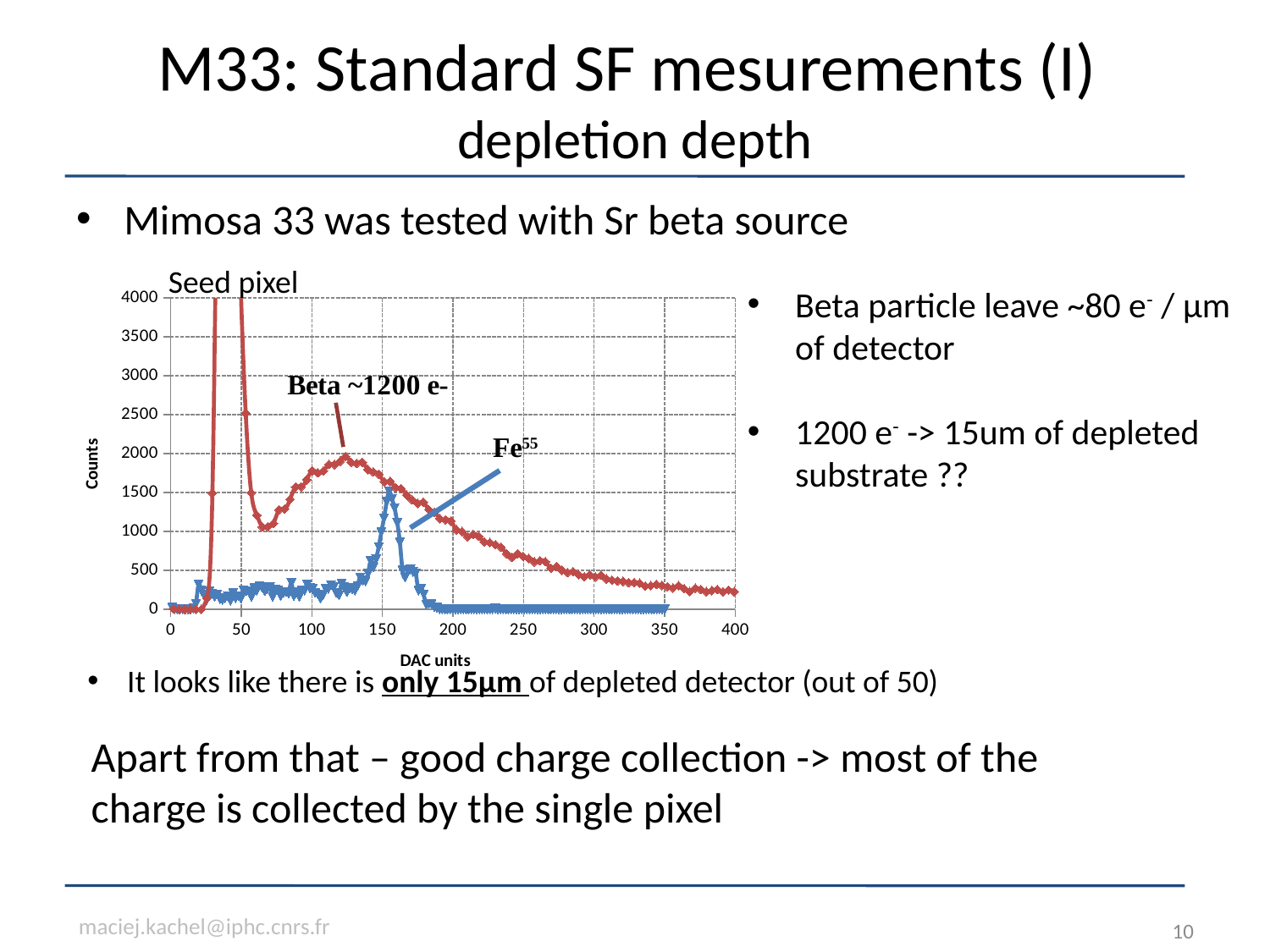
What is the title of the chart? Seed pixel How many data series are plotted on the chart? 2 What kind of chart is shown on the slide? line chart Does the red (Beta) series rise or fall between 200 and 400 DAC units? fall Is the value of the red (Beta) series at 400 DAC units greater or less than 500? less Is the value of the blue (Fe55) series at 100 DAC units greater or less than 500? less What is the label of the x axis of the chart? DAC units Is the value of the blue (Fe55) series at 300 DAC units greater or less than 500? less What is the highest value shown on the y axis of the chart? 4000 At 250 DAC units, which series has the larger value, the red (Beta) or the blue (Fe55)? red (Beta)